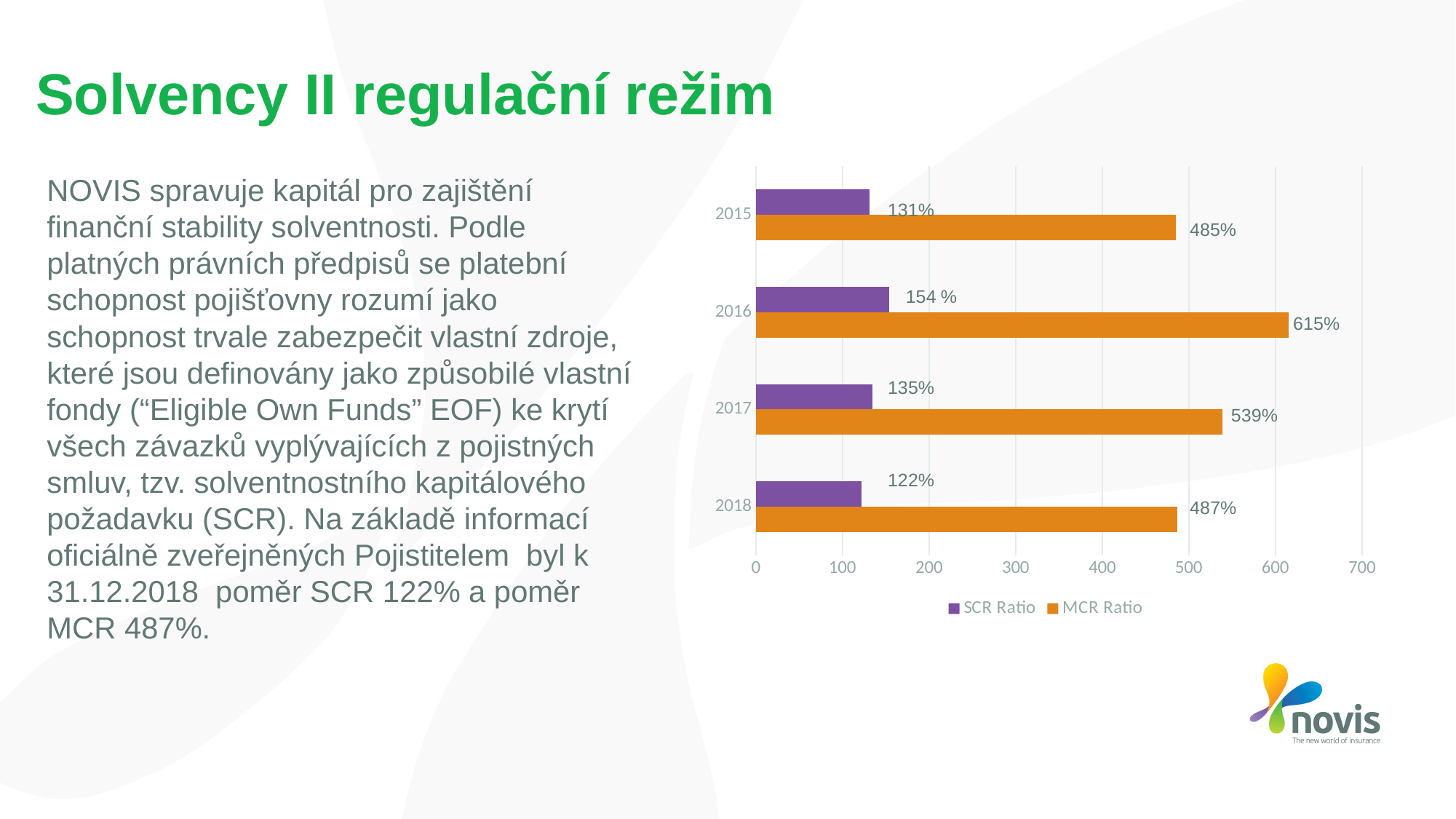
How many series does the legend list? 2 What is the SCR Ratio for 2016? 154 % What is the difference between the SCR Ratio in 2017 and in 2018? 13% What is the MCR Ratio for 2016? 615% What is the SCR Ratio for 2018? 122% Which is larger, the SCR Ratio for 2016 or the SCR Ratio for 2015? 2016 Which year has the lowest SCR Ratio? 2018 What is the MCR Ratio for 2017? 539% Is the MCR Ratio for 2017 greater or less than 500? greater Which year has the highest MCR Ratio? 2016 How many years are shown on the chart? 4 What kind of chart is shown on the slide? bar chart